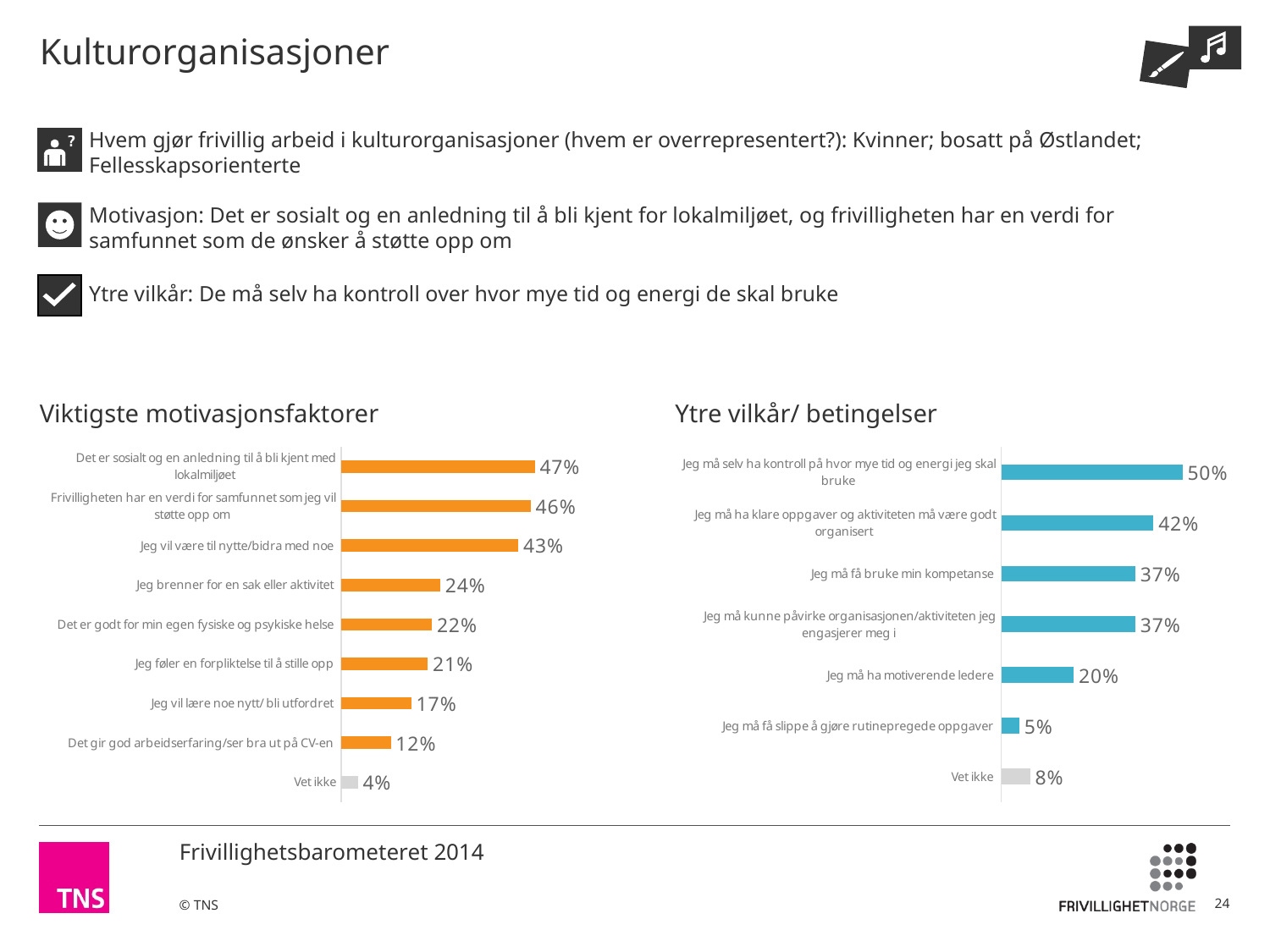
How many categories are shown in the 'Ytre vilkår/ betingelser' chart? 7 In the 'Ytre vilkår/ betingelser' chart, which category has the lowest value? Jeg må få slippe å gjøre rutinepregede oppgaver In the 'Viktigste motivasjonsfaktorer' chart, what is the value for 'Jeg brenner for en sak eller aktivitet'? 24% In the 'Viktigste motivasjonsfaktorer' chart, which is larger: 'Det er godt for min egen fysiske og psykiske helse' or 'Det gir god arbeidserfaring/ser bra ut på CV-en'? Det er godt for min egen fysiske og psykiske helse In the 'Viktigste motivasjonsfaktorer' chart, what is the difference between 'Jeg vil være til nytte/bidra med noe' and 'Jeg vil lære noe nytt/ bli utfordret'? 26% In the 'Ytre vilkår/ betingelser' chart, what is the value for 'Vet ikke'? 8% How many categories are shown in the 'Viktigste motivasjonsfaktorer' chart? 9 In the 'Viktigste motivasjonsfaktorer' chart, what is the value for 'Frivilligheten har en verdi for samfunnet som jeg vil støtte opp om'? 46% What type of chart is the 'Ytre vilkår/ betingelser' chart? Bar chart In the 'Viktigste motivasjonsfaktorer' chart, which category has the highest value? Det er sosialt og en anledning til å bli kjent med lokalmiljøet In the 'Ytre vilkår/ betingelser' chart, what is the value for 'Jeg må ha motiverende ledere'? 20% In the 'Ytre vilkår/ betingelser' chart, what is the difference between 'Jeg må selv ha kontroll på hvor mye tid og energi jeg skal bruke' and 'Jeg må ha klare oppgaver og aktiviteten må være godt organisert'? 8%